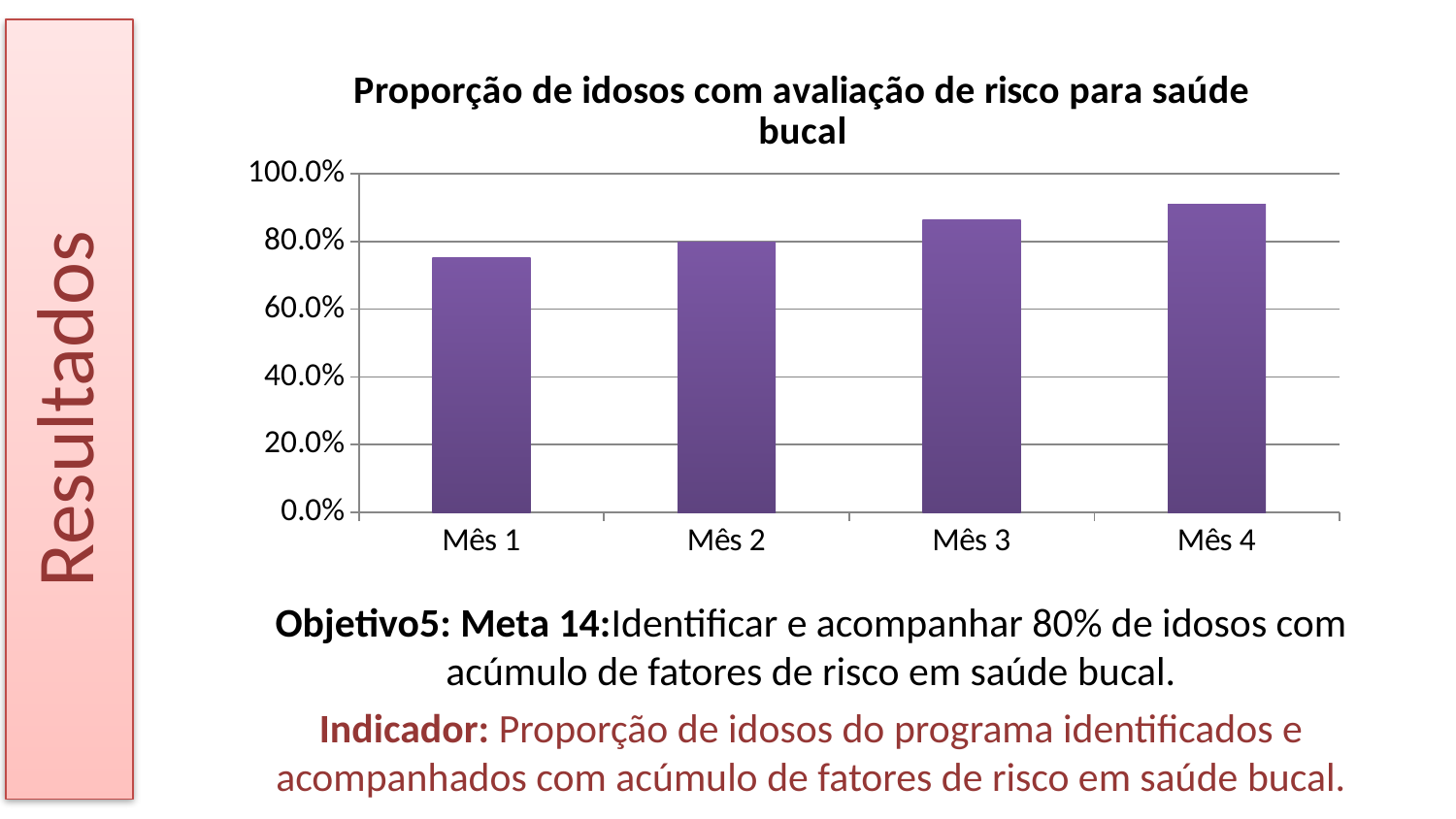
Do the values rise or fall from Mês 1 to Mês 4? rise Which month has the lowest proportion? Mês 1 What kind of chart is shown on the slide? bar chart What is the title of the chart? Proporção de idosos com avaliação de risco para saúde bucal Which is larger, the value for Mês 3 or the value for Mês 1? Mês 3 Which month has the highest proportion? Mês 4 How many categories (months) are plotted on the x axis? 4 Is the value for Mês 4 greater or less than 100.0%? less Is the value for Mês 1 greater or less than 60.0%? greater What is the highest value shown on the y axis? 100.0% Is the value for Mês 3 greater or less than 80.0%? greater